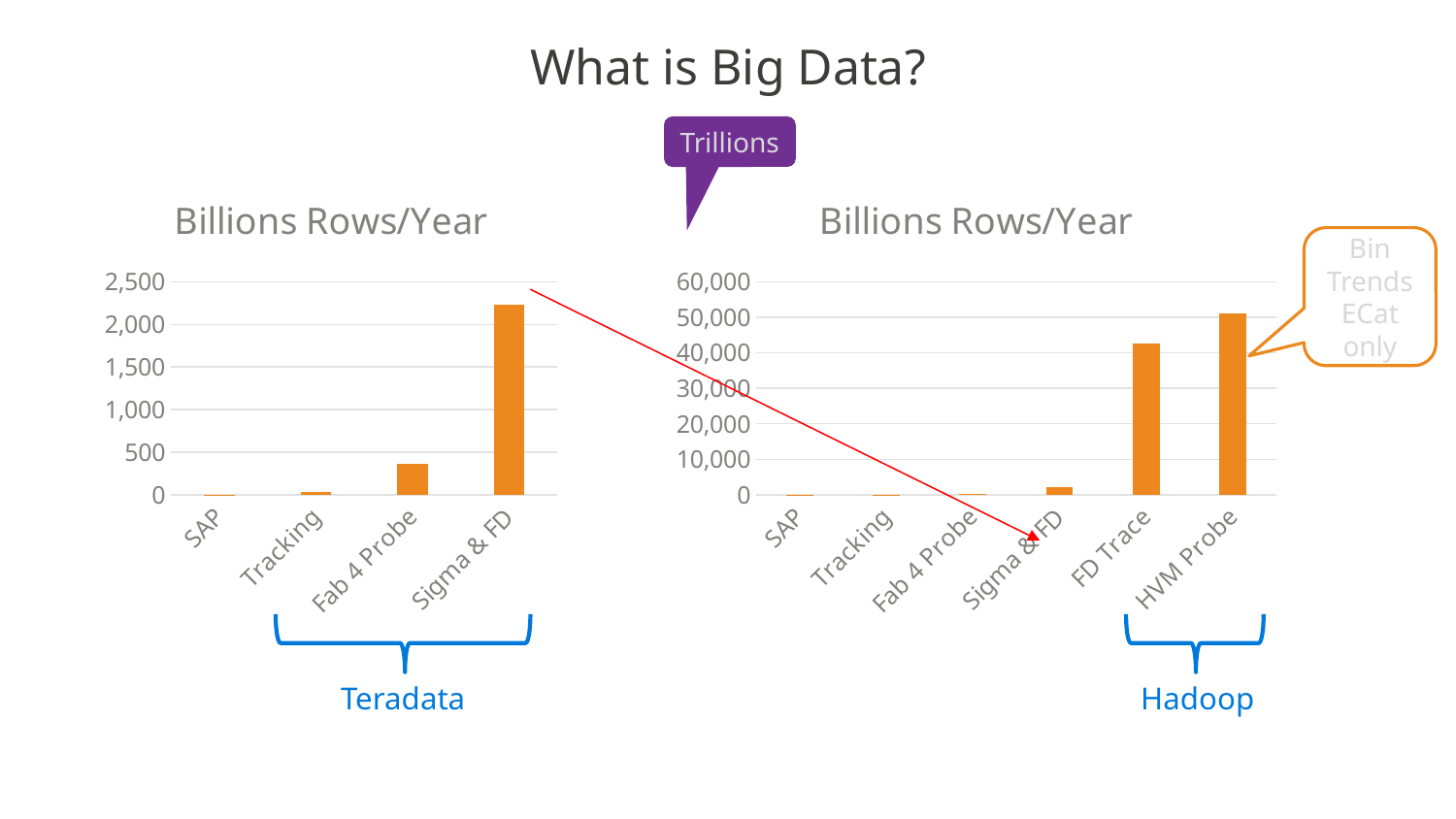
How many categories are shown on the right chart? 6 On the right chart, which category has the highest value? HVM Probe On the right chart, is the value for FD Trace greater or less than 40,000? greater On the left chart, which category has the highest value? Sigma & FD What is the title of the left chart? Billions Rows/Year On the right chart, which is larger, the value for HVM Probe or the value for FD Trace? HVM Probe What type of chart is the right chart? bar chart How many categories are shown on the left chart? 4 On the right chart, is the value for Sigma & FD greater or less than 10,000? less On the left chart, is the value for Fab 4 Probe greater or less than 500? less On the left chart, which is larger, the value for Fab 4 Probe or the value for Tracking? Fab 4 Probe